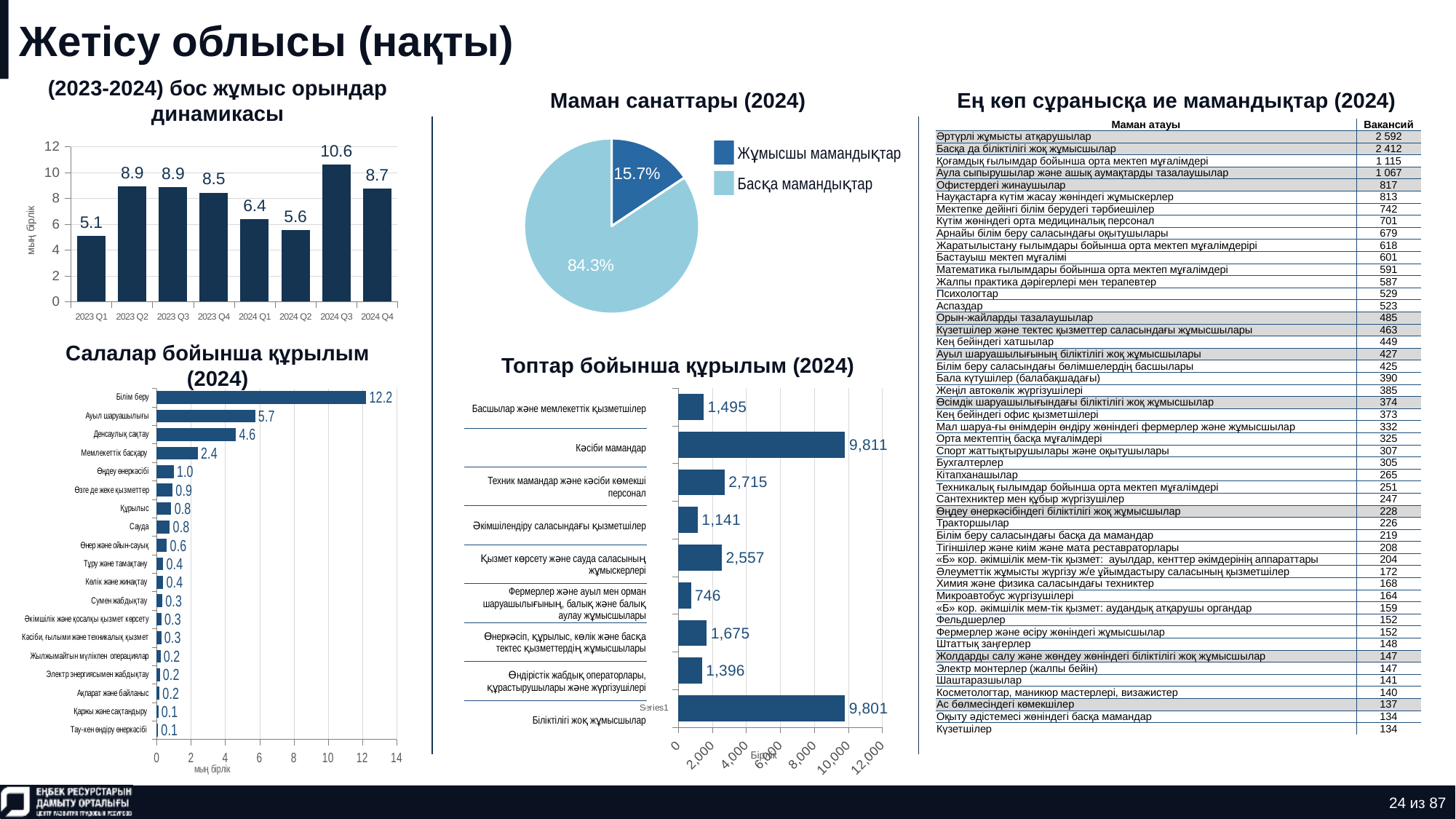
In the chart 'Салалар бойынша құрылым (2024)', which is larger: 'Ауыл шаруашылығы' or 'Денсаулық сақтау'? Ауыл шаруашылығы In the pie chart 'Маман санаттары (2024)', how many entries does the legend list? 2 In the chart 'Топтар бойынша құрылым (2024)', what is the value for 'Кәсіби мамандар'? 9,811 What kind of chart is 'Салалар бойынша құрылым (2024)'? Bar chart In the chart '(2023-2024) бос жұмыс орындар динамикасы', which quarter has the lowest value? 2023 Q1 In the pie chart 'Маман санаттары (2024)', what share is 'Жұмысшы мамандықтар'? 15.7% In the chart 'Топтар бойынша құрылым (2024)', which category has the lowest value? Фермерлер және ауыл мен орман шаруашылығының, балық және балық аулау жұмысшылары In the chart '(2023-2024) бос жұмыс орындар динамикасы', what is the value for 2024 Q3? 10.6 In the chart 'Топтар бойынша құрылым (2024)', how many categories are plotted? 9 In the chart 'Салалар бойынша құрылым (2024)', what is the value for 'Білім беру'? 12.2 In the chart '(2023-2024) бос жұмыс орындар динамикасы', how many quarters are plotted? 8 In the chart '(2023-2024) бос жұмыс орындар динамикасы', what is the difference between 2024 Q3 and 2024 Q2? 5.0